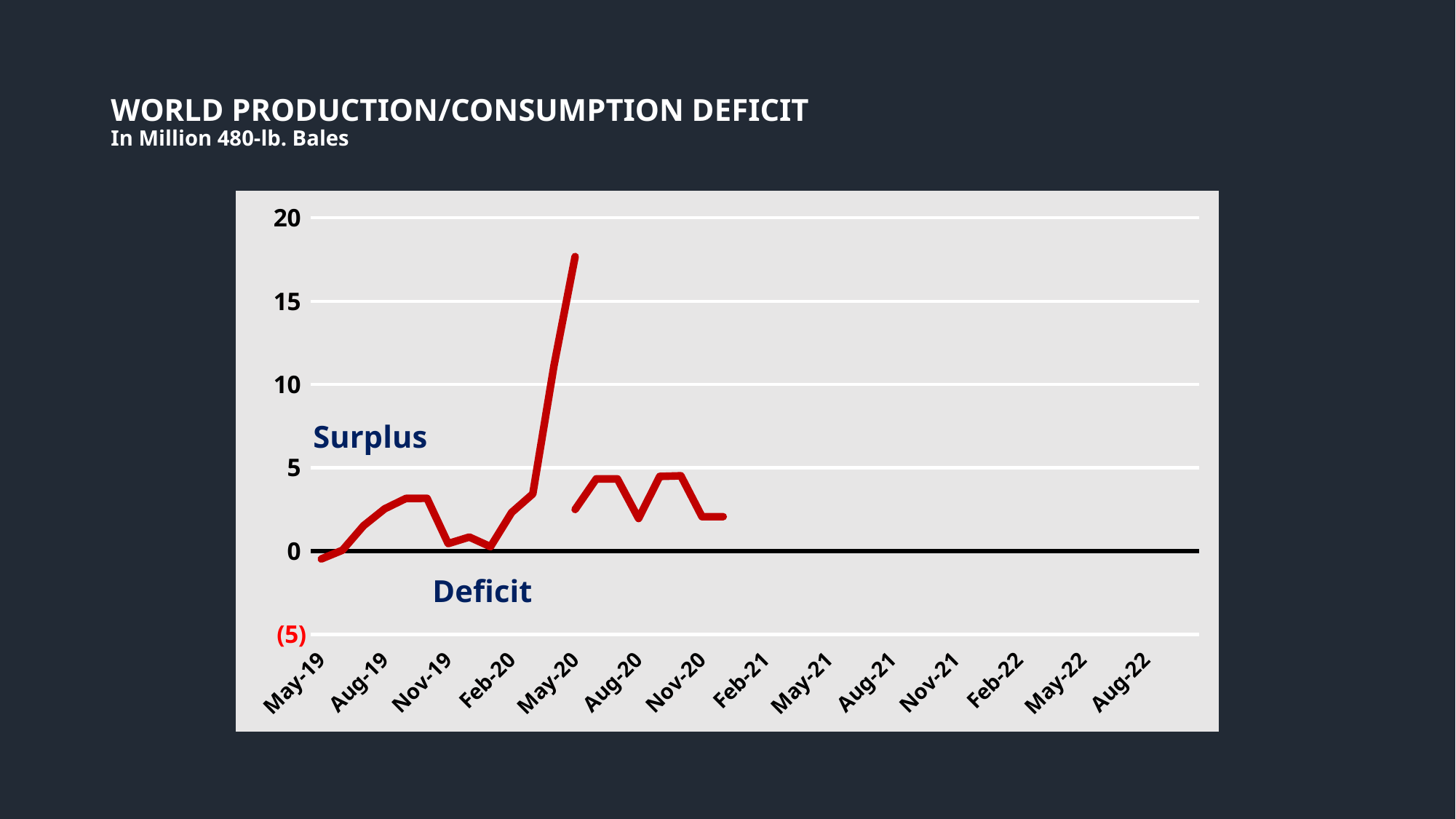
Is the value at Aug-20 greater or less than 0? greater How many date labels are shown on the x axis? 14 Does the line rise or fall between Aug-19 and Nov-19? fall Which is larger, the value at May-20 or the value at Aug-20? May-20 Is the value at Nov-20 greater or less than 10? less Is the value at May-20 greater or less than 15? greater In what units are the values on the chart expressed, according to the subtitle? Million 480-lb. Bales What kind of chart is shown on the slide? line chart Does the line rise or fall between Feb-20 and May-20? rise What is the title of the chart? WORLD PRODUCTION/CONSUMPTION DEFICIT At which x-axis date does the line reach its highest point? May-20